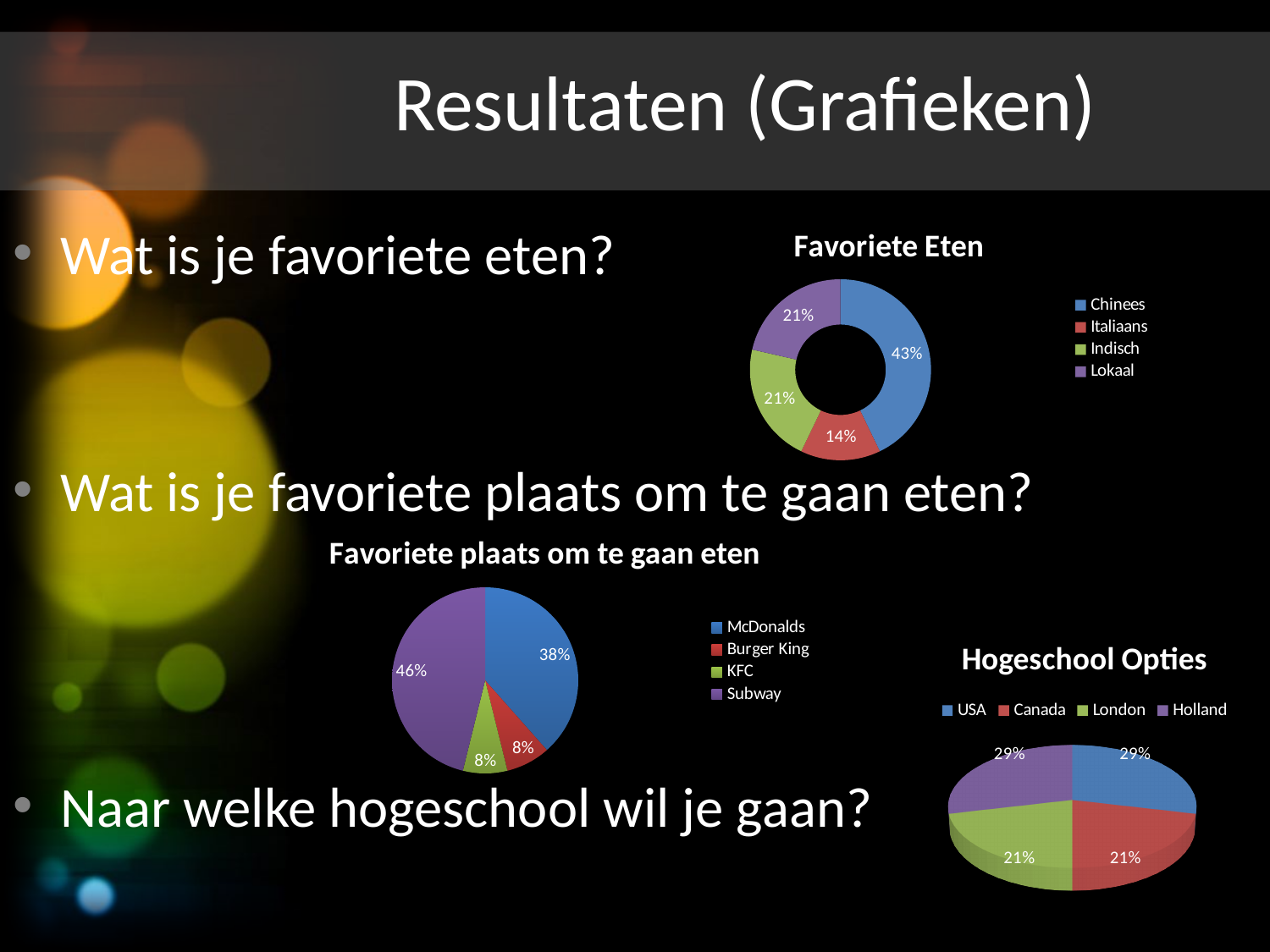
What colour represents KFC in the "Favoriete plaats om te gaan eten" chart? Green In the "Favoriete Eten" chart, what share is Chinees? 43% In the "Favoriete plaats om te gaan eten" chart, which category has the largest share? Subway How many categories does the legend of the "Favoriete Eten" chart list? 4 In the "Favoriete plaats om te gaan eten" chart, which is larger, McDonalds or Burger King? McDonalds In the "Hogeschool Opties" chart, what share is Holland? 29% In the "Hogeschool Opties" chart, what share is Canada? 21% In the "Favoriete plaats om te gaan eten" chart, what share is Subway? 46% In the "Favoriete Eten" chart, what is the difference between the Chinees and Italiaans shares? 29% What kind of chart is "Favoriete plaats om te gaan eten"? Pie chart In the "Favoriete Eten" chart, which category has the smallest share? Italiaans In the "Hogeschool Opties" chart, what is the difference between the USA and London shares? 8%